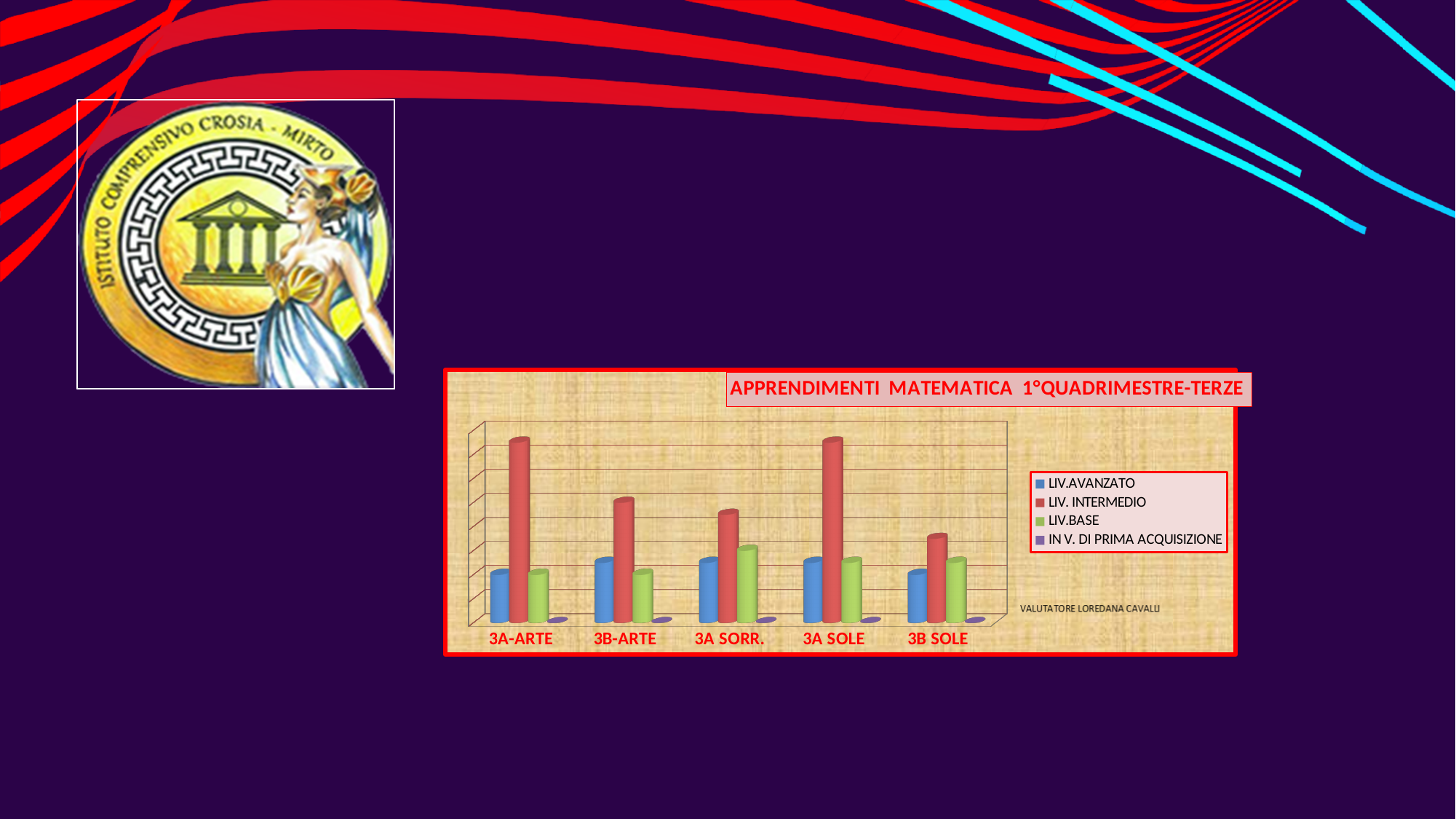
How many series does the chart's legend list? 4 Which series has the lowest bar in every class? IN V. DI PRIMA ACQUISIZIONE Which is larger for 3A SOLE: LIV. INTERMEDIO or LIV.BASE? LIV. INTERMEDIO Which class has the lowest LIV. INTERMEDIO bar? 3B SOLE How many classes (categories) are shown on the x axis of the chart? 5 What kind of chart is shown on the slide? bar chart Which series is shown in red in the chart? LIV. INTERMEDIO What is the title of the chart? APPRENDIMENTI MATEMATICA 1°QUADRIMESTRE-TERZE Which is larger: LIV. INTERMEDIO for 3B-ARTE or LIV. INTERMEDIO for 3B SOLE? 3B-ARTE For 3A SORR., which is larger: LIV.BASE or LIV.AVANZATO? LIV.BASE Which class has the highest LIV.BASE bar? 3A SORR. For 3A-ARTE, which series has the tallest bar? LIV. INTERMEDIO